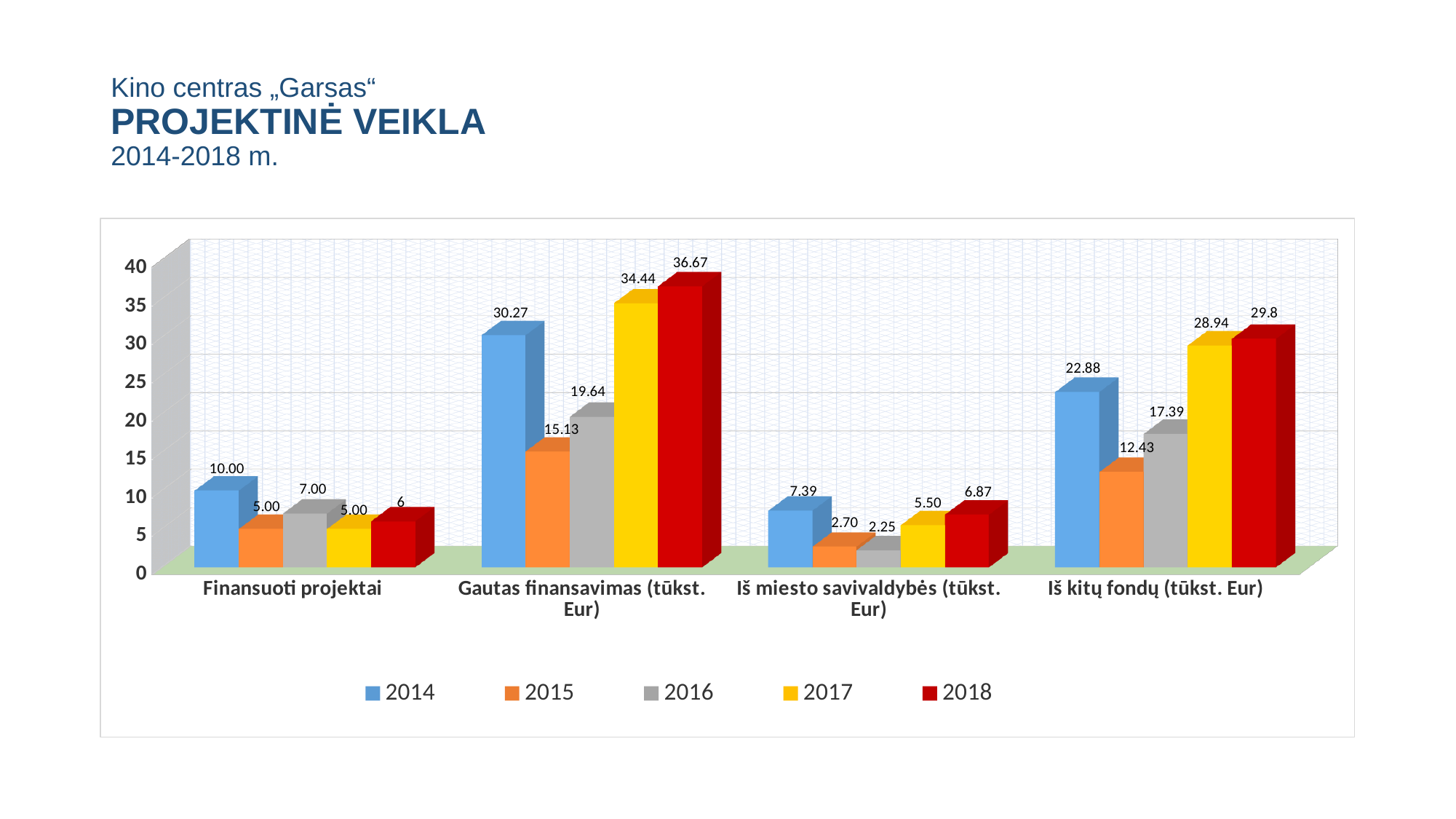
What is the value for 2014 in the "Finansuoti projektai" category? 10.00 What is the value for 2015 in the "Iš miesto savivaldybės (tūkst. Eur)" category? 2.70 Which year has the highest value in the "Gautas finansavimas (tūkst. Eur)" category? 2018 How many series does the legend list? 5 How many categories are shown on the x axis? 4 What kind of chart is shown on the slide? Bar chart What is the value for 2018 in the "Gautas finansavimas (tūkst. Eur)" category? 36.67 What is the difference between the 2017 and 2016 values in the "Iš kitų fondų (tūkst. Eur)" category? 11.55 Which colour represents the 2017 series in the legend? Yellow Which is larger in the "Gautas finansavimas (tūkst. Eur)" category: the 2014 value or the 2016 value? 2014 Which year has the lowest value in the "Iš miesto savivaldybės (tūkst. Eur)" category? 2016 What is the value for 2016 in the "Iš kitų fondų (tūkst. Eur)" category? 17.39